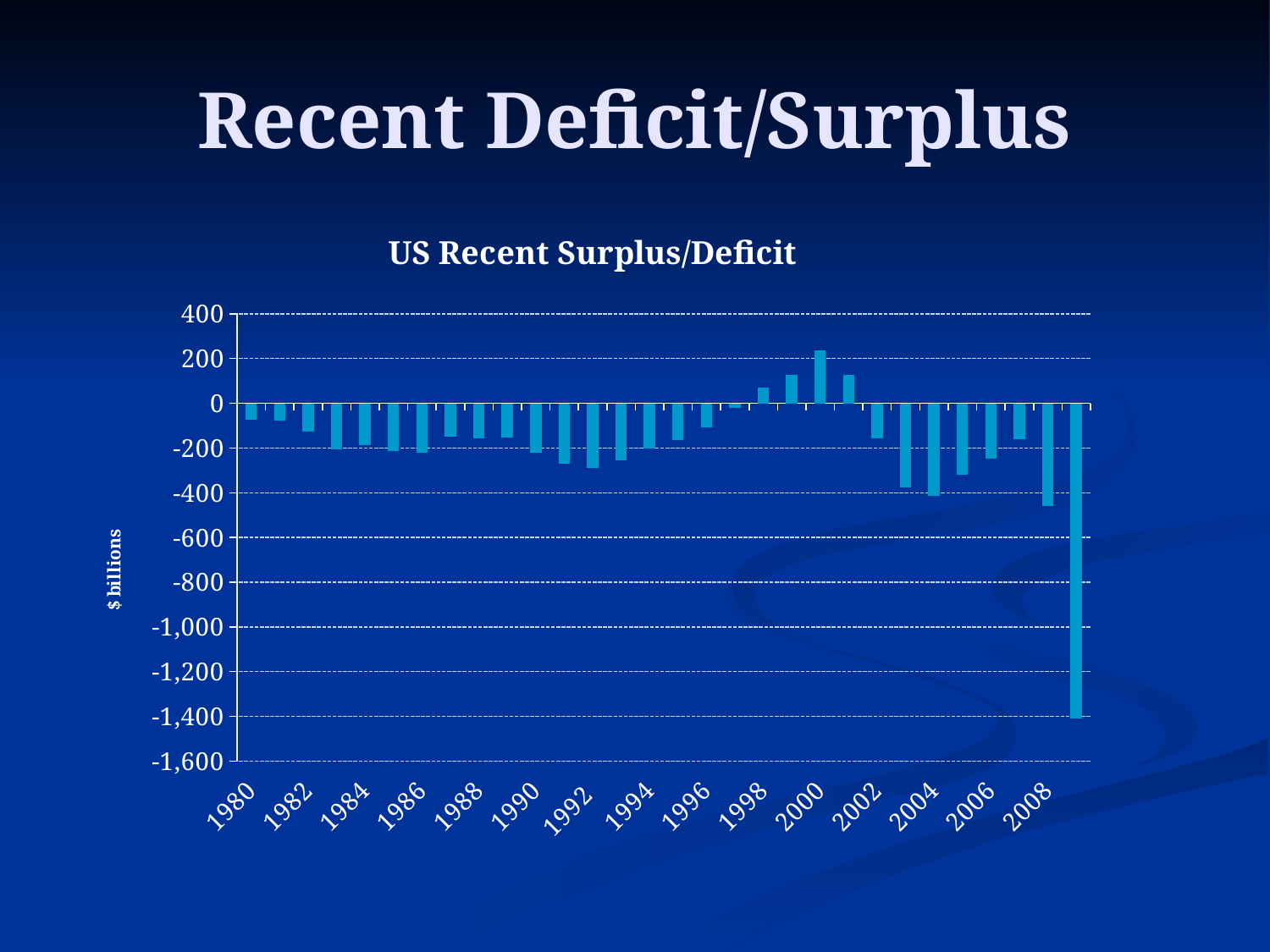
Is the value for 1992 greater or less than -200? less Is the value for 1980 greater or less than -200? greater Which labeled year has the highest value in the chart? 2000 Which is larger, the value for 2000 or the value for 1998? 2000 Is the value for 2000 greater or less than 200? greater What is the title of the chart? US Recent Surplus/Deficit What kind of chart is shown on the slide? bar chart Do the values rise or fall from 2000 to 2004? fall What is the label on the vertical axis of the chart? $ billions